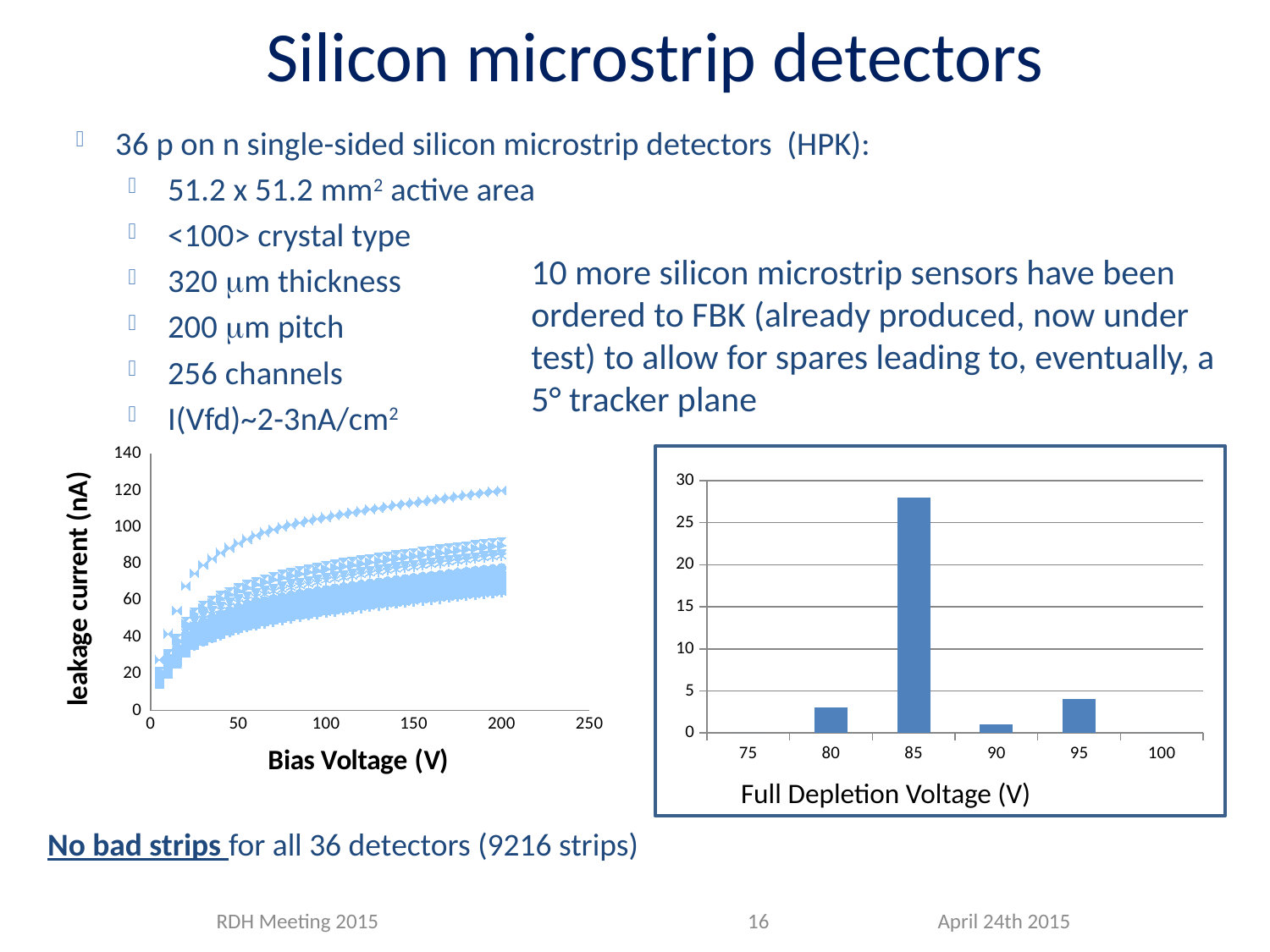
What is the x-axis title of the chart on the left? Bias Voltage (V) In the leakage current chart on the left, does the leakage current rise or fall as the bias voltage increases? rise In the Full Depletion Voltage chart, which voltage category has the tallest bar? 85 In the Full Depletion Voltage chart, is the value for 90 greater or less than 5? less In the Full Depletion Voltage chart, is the value for 80 greater or less than 5? less What kind of chart is the chart on the right (Full Depletion Voltage)? bar chart How many voltage categories are shown on the x axis of the Full Depletion Voltage chart? 6 In the Full Depletion Voltage chart, is the value for 95 greater or less than 5? less In the Full Depletion Voltage chart, which has the larger value, 80 or 90? 80 What is the y-axis title of the chart on the left? leakage current (nA) In the Full Depletion Voltage chart, which has the larger value, 85 or 95? 85